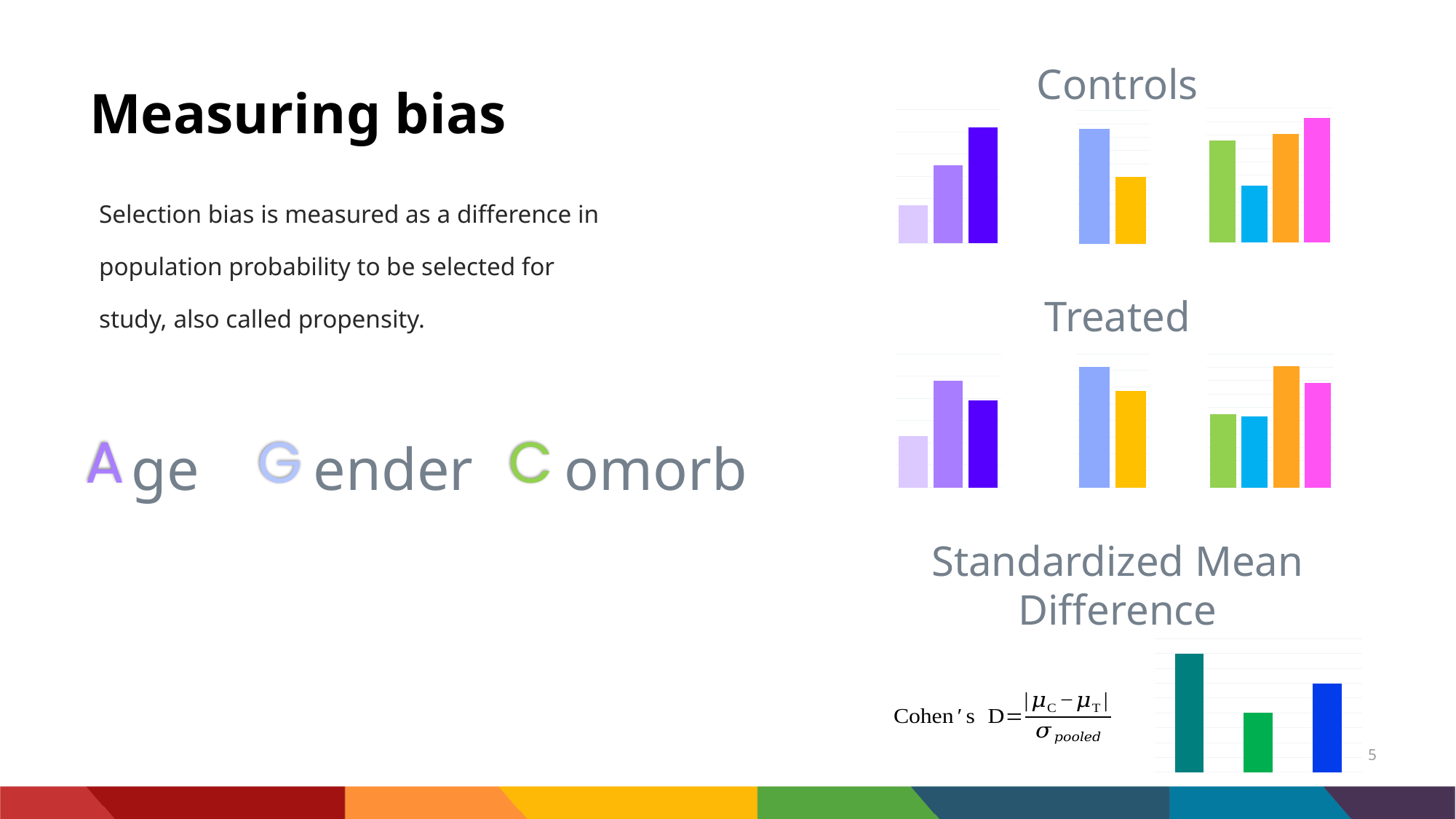
In the Standardized Mean Difference chart, which bar is the tallest? the leftmost (teal) bar What kind of chart is the Standardized Mean Difference chart at the bottom right? bar chart What is the title of the chart at the bottom right of the slide? Standardized Mean Difference In the leftmost Treated chart (purple bars), which bar is the tallest? the middle bar In the rightmost Treated chart, which colour bar is the tallest? orange How many bars does the Standardized Mean Difference chart have? 3 In the middle Controls chart, is the blue bar or the yellow bar taller? the blue bar In the rightmost Controls chart, which colour bar is the shortest? light blue In the Standardized Mean Difference chart, which bar is the shortest? the middle (green) bar In the leftmost Controls chart (purple bars), do the bars rise or fall from left to right? rise How many bars does the leftmost Controls chart have? 3